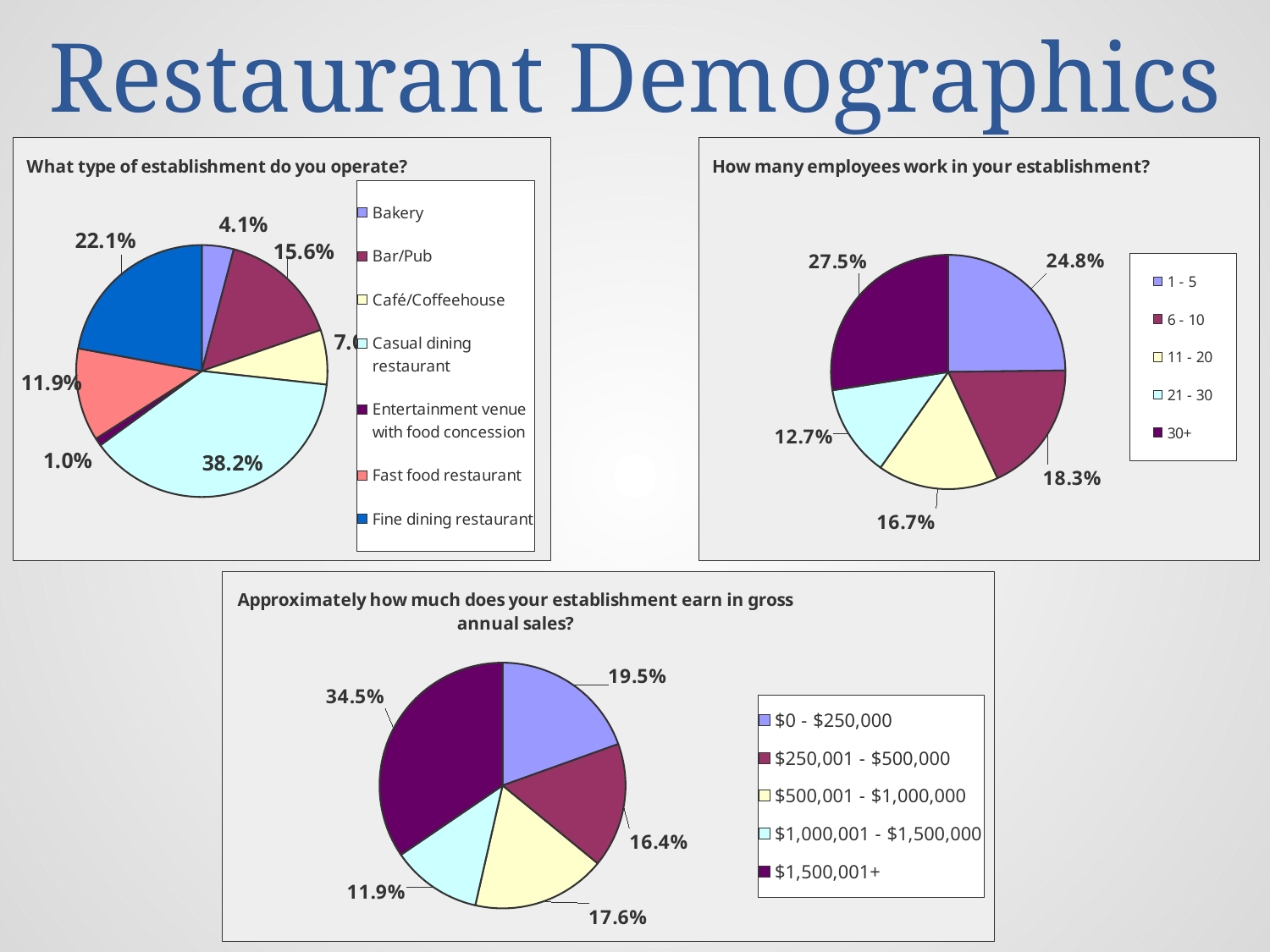
In the chart 'How many employees work in your establishment?', what is the difference between the 1 - 5 share and the 6 - 10 share? 6.5% In the chart 'What type of establishment do you operate?', what share is Casual dining restaurant? 38.2% In the chart 'How many employees work in your establishment?', what share is 30+? 27.5% What type of chart is used for the gross annual sales question? Pie chart In the chart 'What type of establishment do you operate?', how many categories does the legend list? 7 In the chart 'What type of establishment do you operate?', which category has the smallest share? Entertainment venue with food concession In the chart about gross annual sales, what share is $500,001 - $1,000,000? 17.6% In the chart about gross annual sales, which category has the largest share? $1,500,001+ In the chart about gross annual sales, what is the difference between the $1,500,001+ share and the $0 - $250,000 share? 15.0% In the chart 'What type of establishment do you operate?', what is the share for Fine dining restaurant? 22.1% In the chart 'How many employees work in your establishment?', which category has the smallest share? 21 - 30 In the chart 'How many employees work in your establishment?', which is larger: 11 - 20 or 21 - 30? 11 - 20